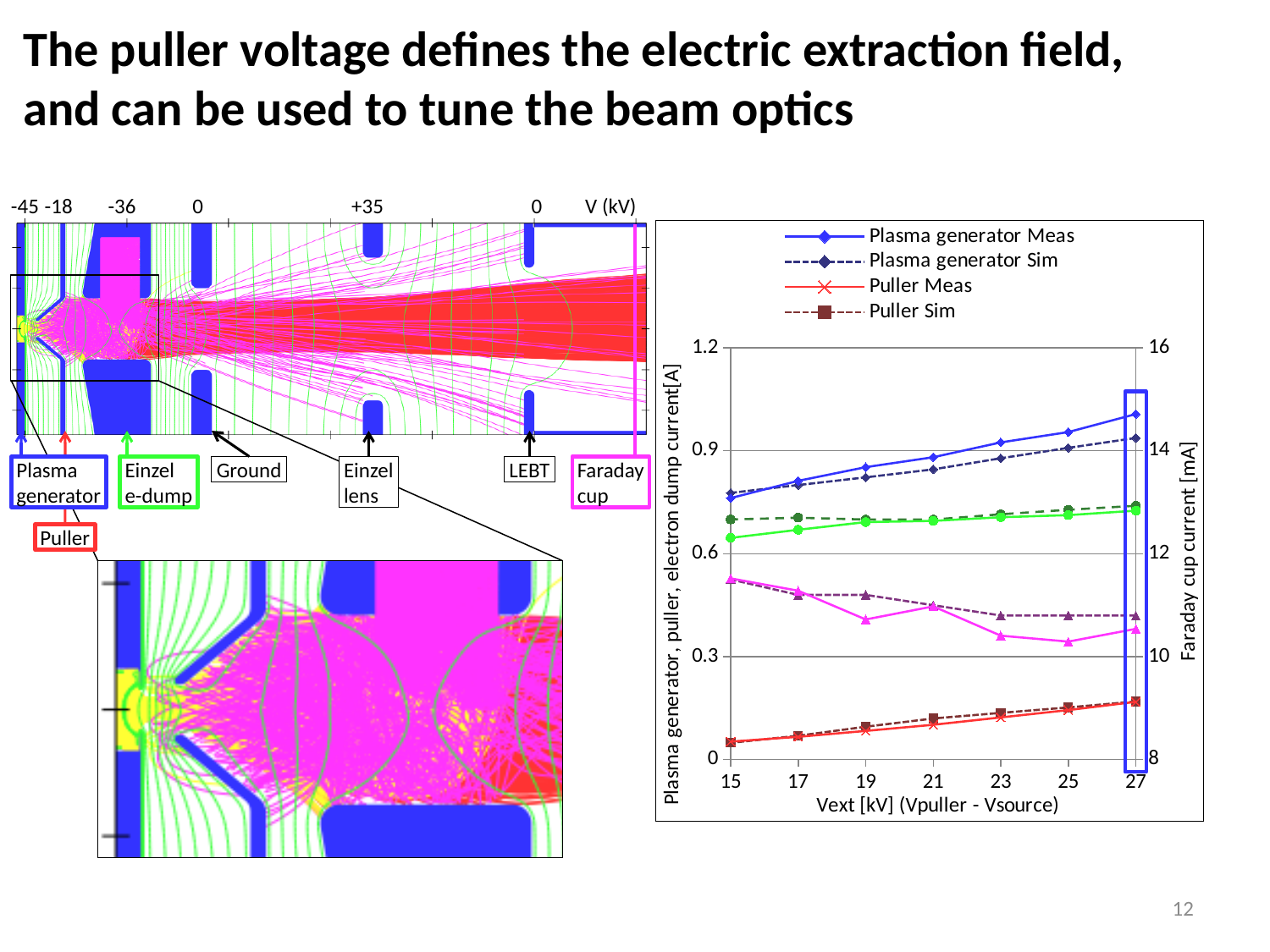
Is the Puller Sim value at Vext = 15 kV greater or less than 0.3? less What is the label of the right-hand y axis of the chart? Faraday cup current [mA] Is the Plasma generator Meas value at Vext = 27 kV greater or less than 0.9? greater Does the Puller Meas series rise or fall as Vext increases from 15 to 27 kV? rise What is the label of the x axis of the chart? Vext [kV] (Vpuller - Vsource) How many Vext values are marked on the x axis of the chart? 7 What kind of chart is shown on the right of the slide? line chart Does the Plasma generator Meas series rise or fall as Vext increases from 15 to 27 kV? rise Is the Puller Meas value at Vext = 27 kV greater or less than 0.3? less How many series does the chart legend list? 4 At Vext = 27 kV, which is larger: Plasma generator Meas or Puller Meas? Plasma generator Meas